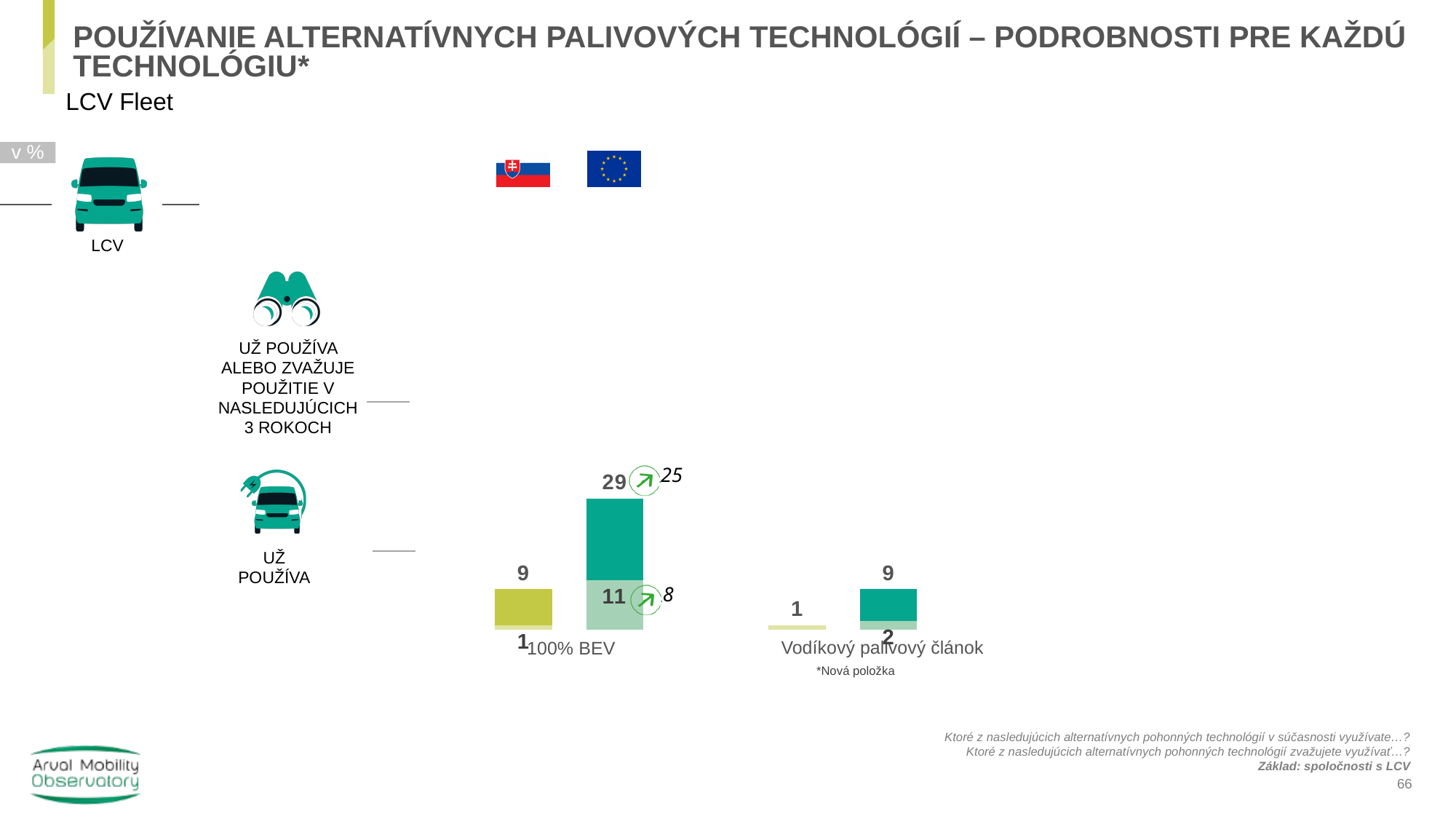
What is the EU (right flag) value for 'Vodíkový palivový článok' in the 'už používa alebo zvažuje' measure? 9 What is the EU (right flag) value for '100% BEV' in the 'už používa' measure? 11 For the EU (right flag), which category has the higher 'už používa alebo zvažuje' value: '100% BEV' or 'Vodíkový palivový článok'? 100% BEV How many technology categories are shown on the x axis of the chart? 2 What is the EU (right flag) value for '100% BEV' in the 'už používa alebo zvažuje použitie v nasledujúcich 3 rokoch' measure? 29 For the EU (right flag), what is the difference between the 'už používa alebo zvažuje' value and the 'už používa' value for '100% BEV'? 18 What is the EU (right flag) value for 'Vodíkový palivový článok' in the 'už používa' measure? 2 What number is shown next to the arrow beside the EU value of 29 for '100% BEV'? 25 For '100% BEV', what is the difference between the EU and Slovakia values in the 'už používa alebo zvažuje' measure? 20 What is the Slovakia (left flag) value for 'Vodíkový palivový článok' in the 'už používa alebo zvažuje' measure? 1 What is the Slovakia (left flag) value for '100% BEV' in the 'už používa alebo zvažuje' measure? 9 What kind of chart is shown on the slide? bar chart